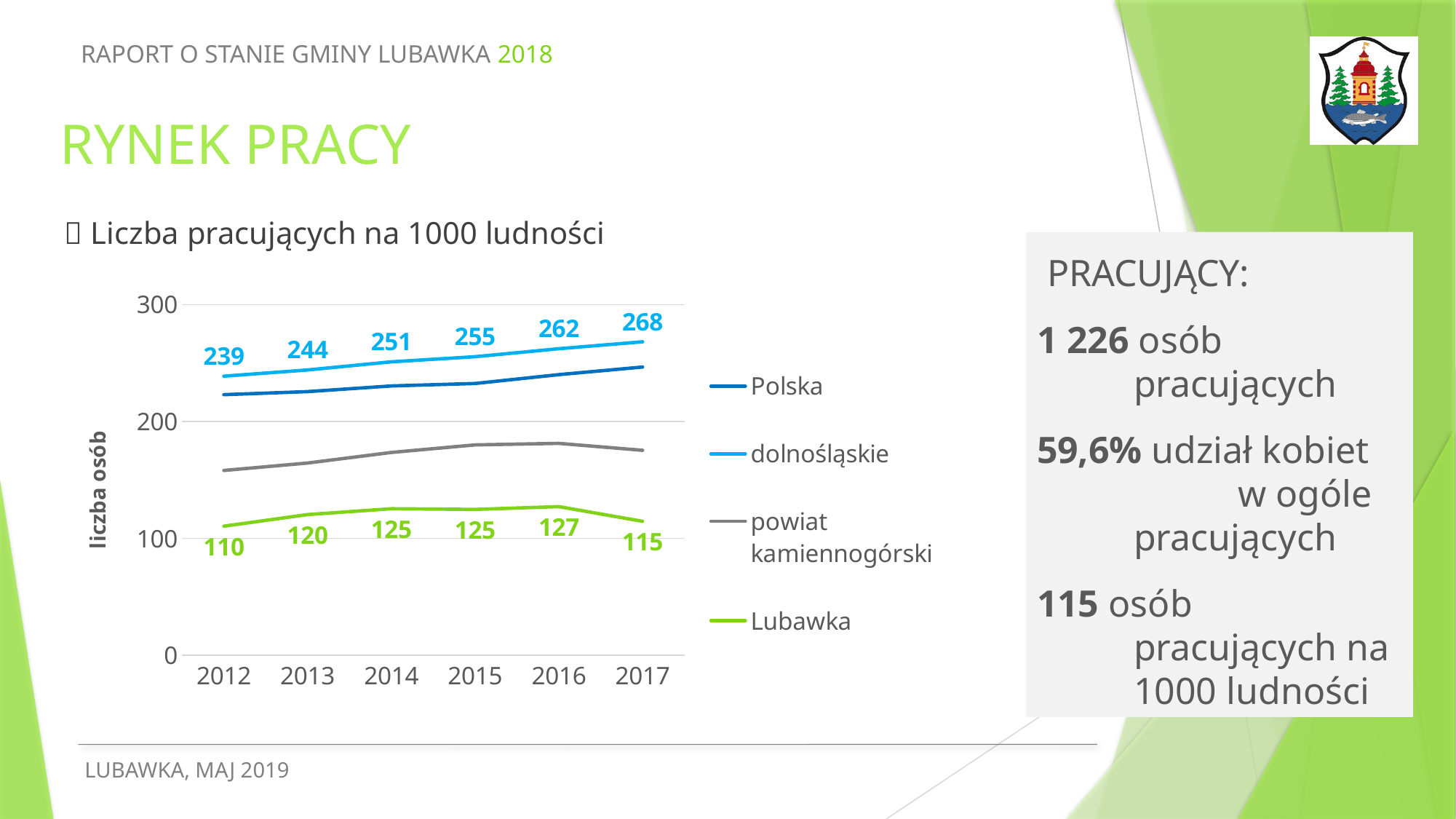
What is the value for Lubawka in 2016? 127 How many years are shown on the x axis of the chart? 6 Which series has the larger value in 2015, dolnośląskie or Lubawka? dolnośląskie In which year is the value for dolnośląskie the highest? 2017 Is the value for powiat kamiennogórski in 2016 greater or less than 200? less Does the dolnośląskie series rise or fall from 2012 to 2017? rise How many series does the chart legend list? 4 What is the value for Lubawka in 2012? 110 In which year is the value for Lubawka the lowest? 2012 What is the value for dolnośląskie in 2017? 268 What is the difference between the dolnośląskie and Lubawka values in 2017? 153 What kind of chart is shown on the slide? line chart